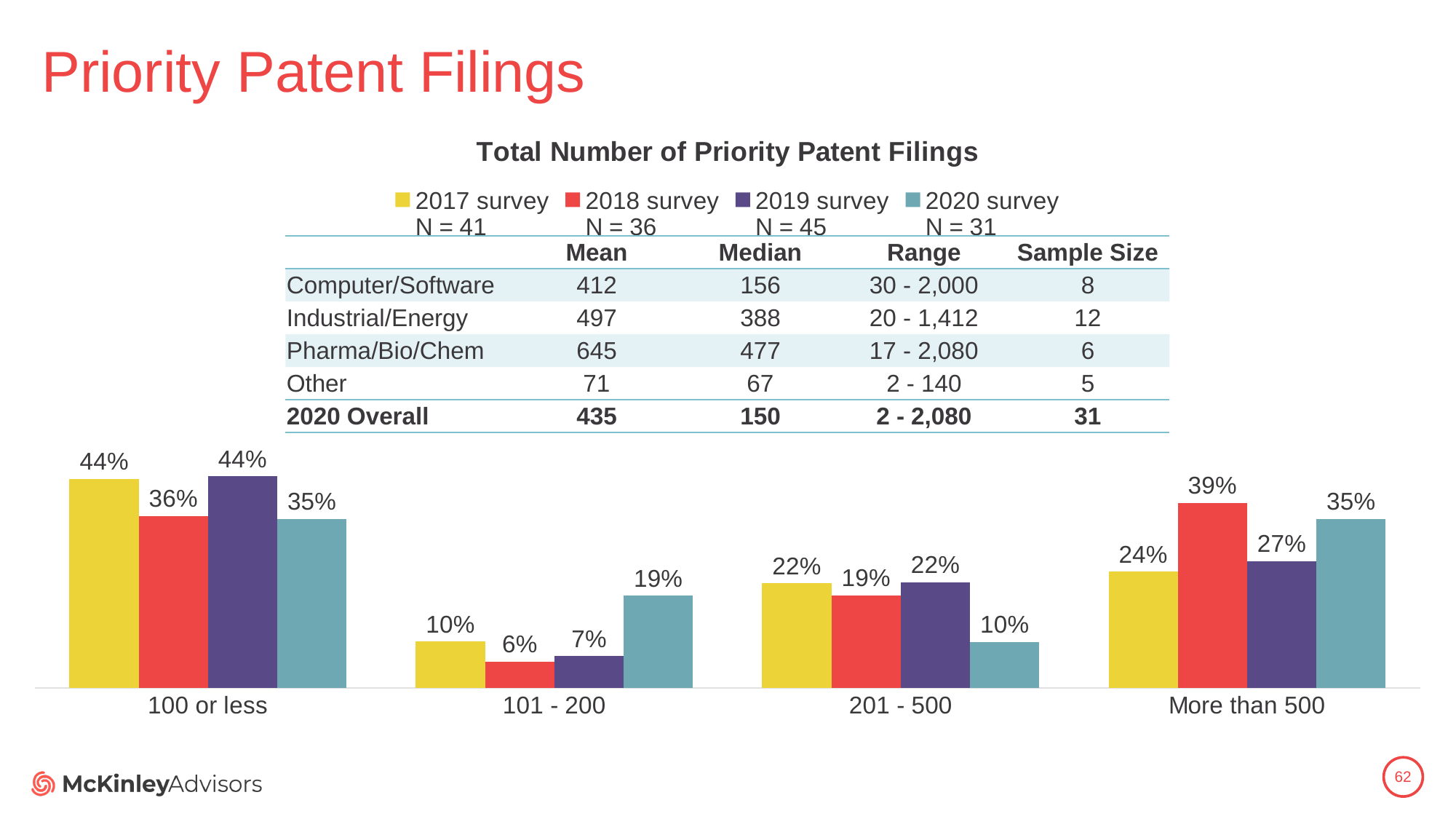
Which category has the highest value for the 2020 survey? 100 or less How many series does the chart legend list? 4 What is the value for the 2017 survey in the '201 - 500' category? 22% What is the title of the chart? Total Number of Priority Patent Filings How many categories are shown along the x axis of the chart? 4 In the '201 - 500' category, which is larger: the 2019 survey value or the 2020 survey value? 2019 survey What kind of chart is shown on the slide? bar chart Which category has the lowest value for the 2018 survey? 101 - 200 What is the value for the 2020 survey in the '101 - 200' category? 19% What is the sample size (N) shown in the legend for the 2019 survey? N = 45 What is the value for the 2018 survey in the 'More than 500' category? 39% What is the difference between the 2018 survey and 2017 survey values in the 'More than 500' category? 15%